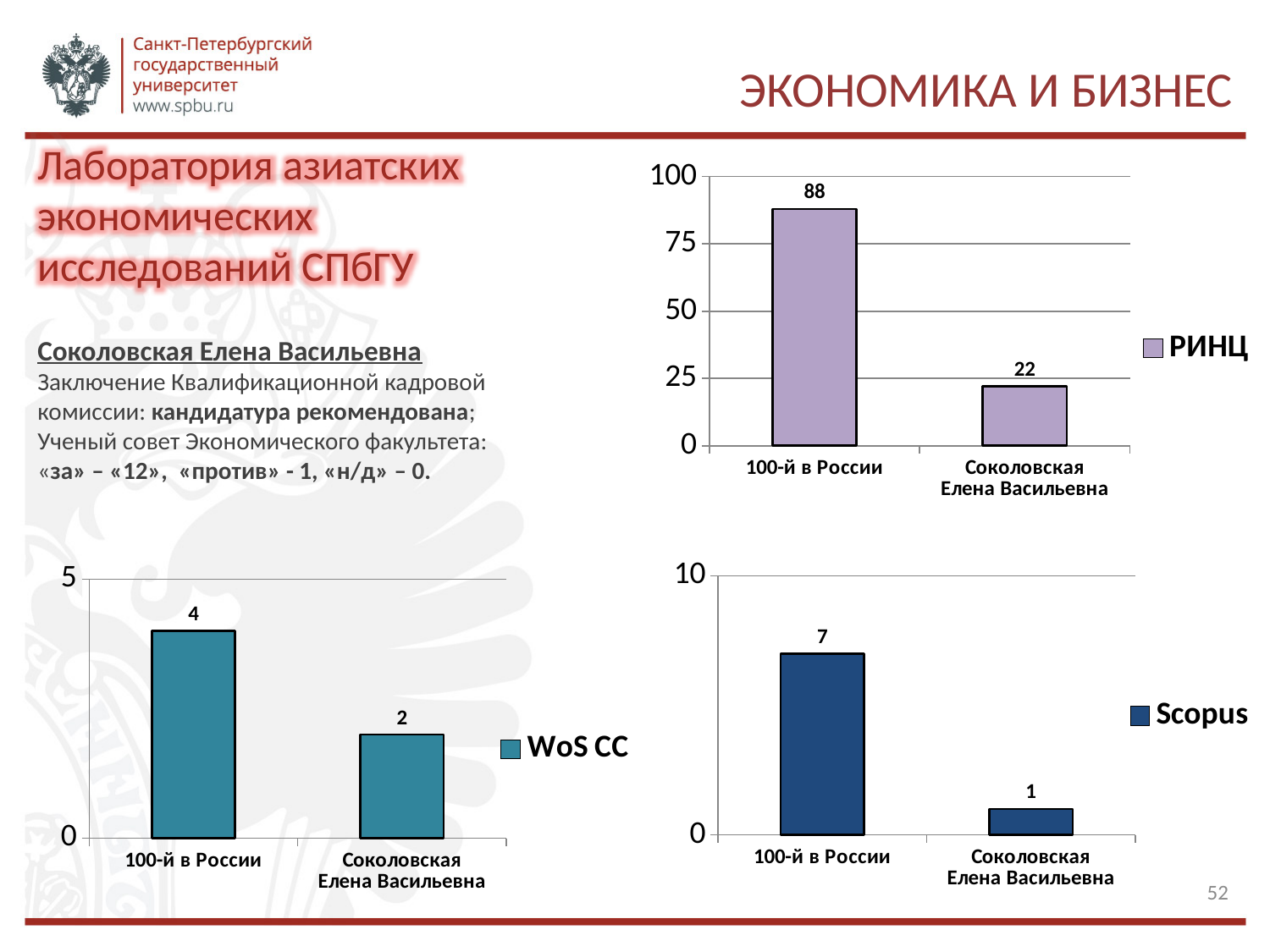
How many categories are shown on the x axis of the Scopus chart (bottom right)? 2 In the РИНЦ chart (top right), is the value for Соколовская Елена Васильевна greater or less than 25? less What kind of chart is the WoS CC chart (bottom left)? bar chart In the Scopus chart (bottom right), what is the value for Соколовская Елена Васильевна? 1 In the РИНЦ chart (top right), what is the difference between the value for 100-й в России and the value for Соколовская Елена Васильевна? 66 In the WoS CC chart (bottom left), which category has the lowest value? Соколовская Елена Васильевна In the WoS CC chart (bottom left), what is the value for Соколовская Елена Васильевна? 2 In the WoS CC chart (bottom left), what is the value for 100-й в России? 4 In the Scopus chart (bottom right), what is the value for 100-й в России? 7 In the Scopus chart (bottom right), which category has the higher value? 100-й в России In the РИНЦ chart (top right), what is the value for 100-й в России? 88 In the РИНЦ chart (top right), what is the value for Соколовская Елена Васильевна? 22